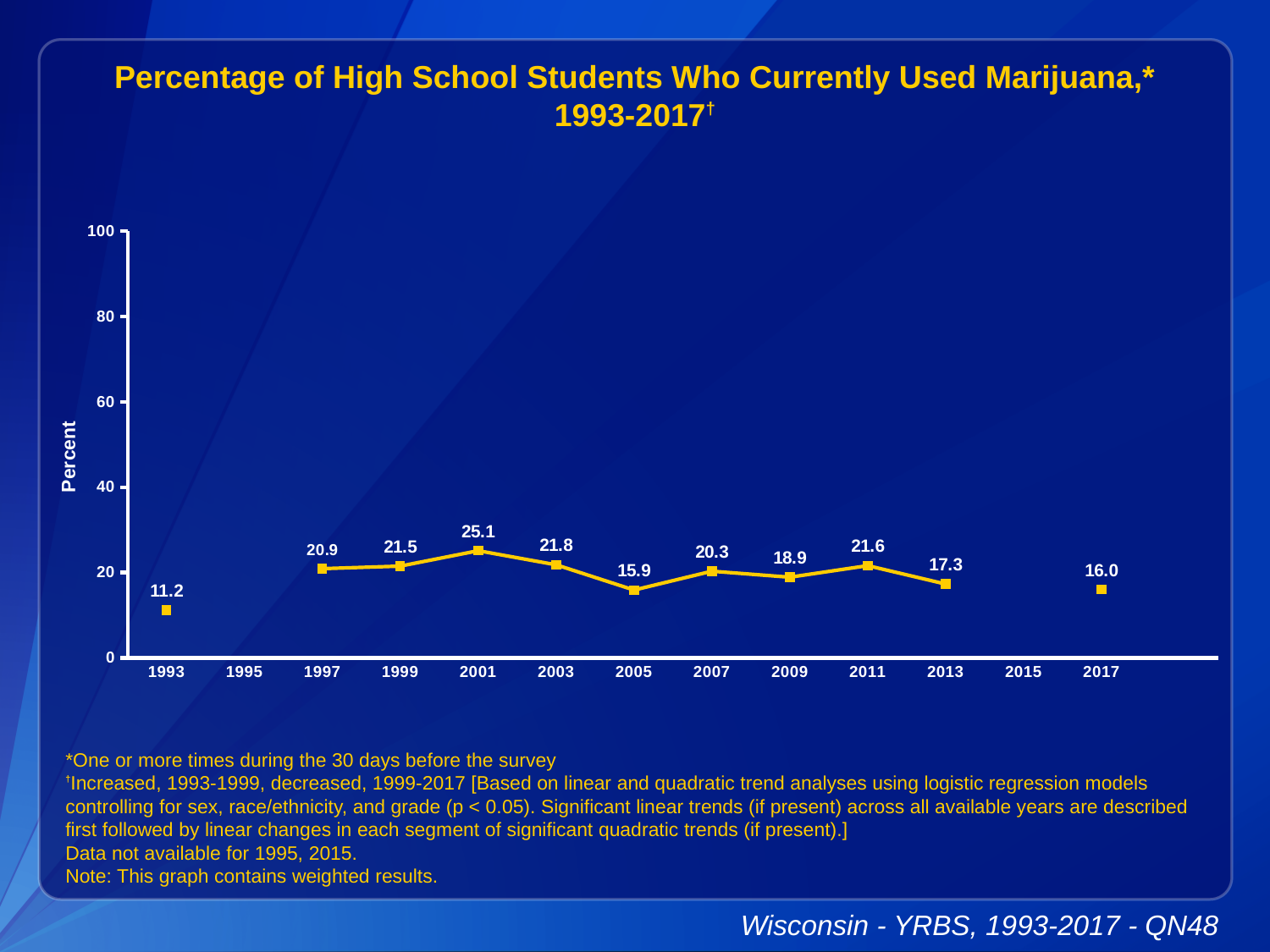
Do the values rise or fall from 2001 to 2005? fall What is the label on the y axis? Percent How many data points are plotted on the chart? 11 What is the value plotted for 1993? 11.2 Which year has the lowest percentage? 1993 Which year has a larger value, 2011 or 2013? 2011 What is the difference between the values for 2001 and 2005? 9.2 Which year has the highest percentage? 2001 What is the value plotted for 2017? 16.0 What is the percentage of high school students who currently used marijuana in 2001? 25.1 What kind of chart is shown on the slide? line chart Is the value for 2009 greater or less than 20? less